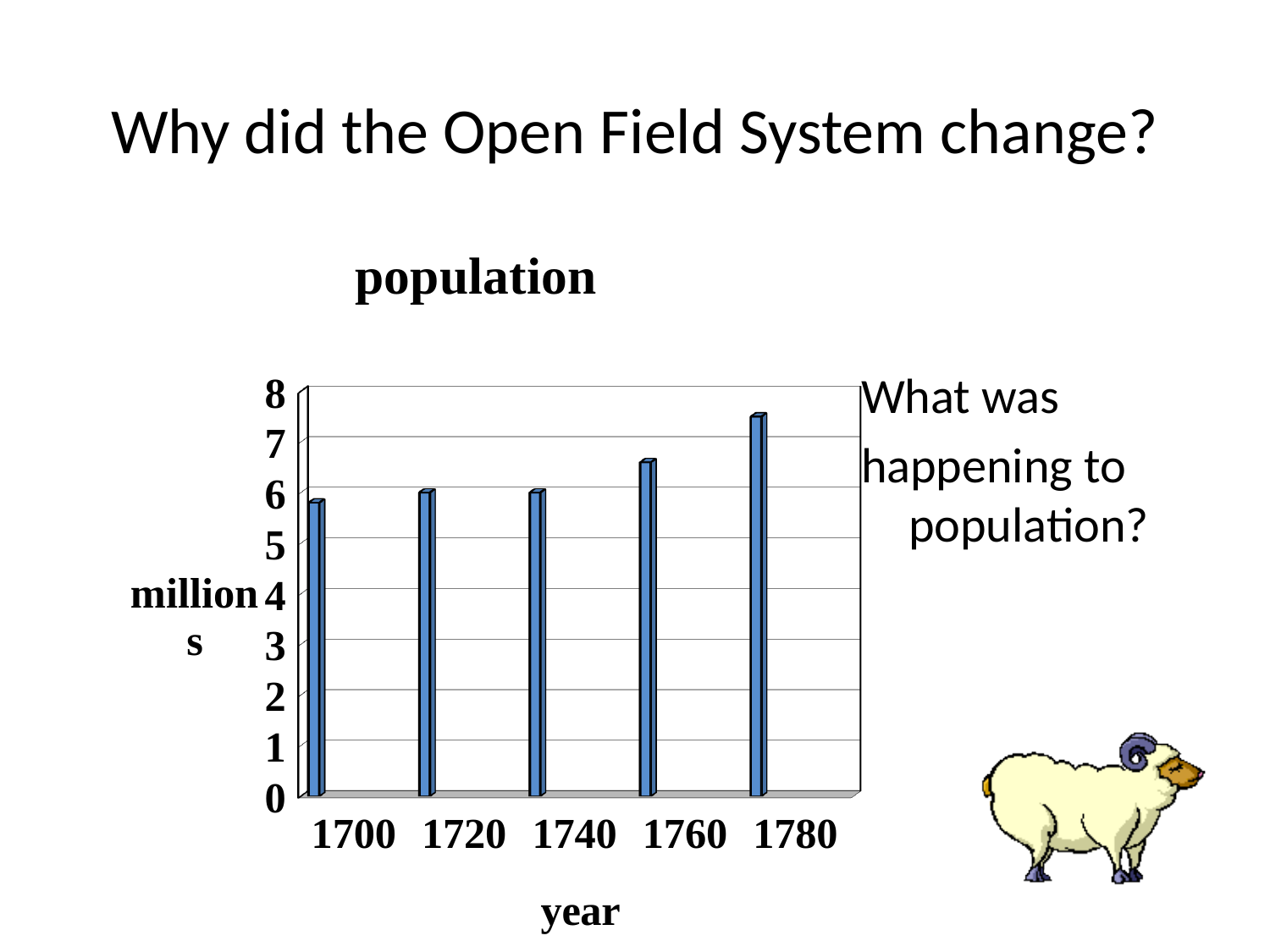
Which year has the lowest population bar? 1700 What kind of chart is shown on the slide? bar chart Do the population values rise or fall from 1700 to 1780? rise What is the label on the vertical axis of the chart? millions How many years are plotted on the chart? 5 Is the population value for 1760 greater or less than 6? greater What is the title of the chart? population Which year has the larger population, 1760 or 1720? 1760 Is the population value for 1740 greater or less than 7? less Is the population value for 1780 greater or less than 7? greater Which year has the highest population bar? 1780